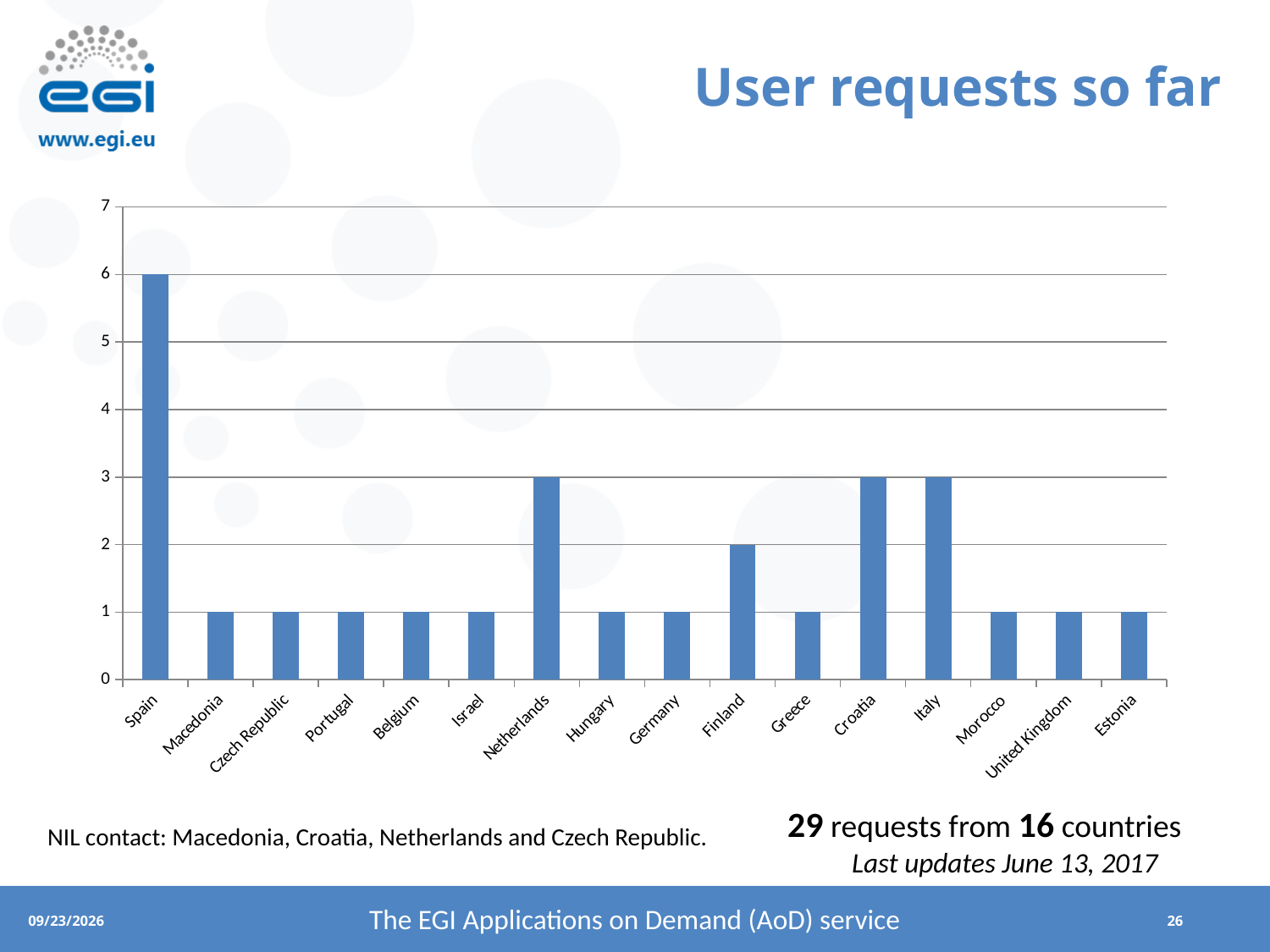
What is the value for Netherlands? 3 What kind of chart is shown on the slide? bar chart What is the title of the chart on the slide? User requests so far Which is larger, the value for Finland or the value for Croatia? Croatia What is the value for Germany? 1 What is the value for Italy? 3 What is the value for Finland? 2 What is the value for Spain? 6 What is the difference between the values for Spain and Croatia? 3 Is the value for Spain greater or less than 5? greater Which country has the highest number of user requests? Spain How many countries are shown on the x axis of the chart? 16